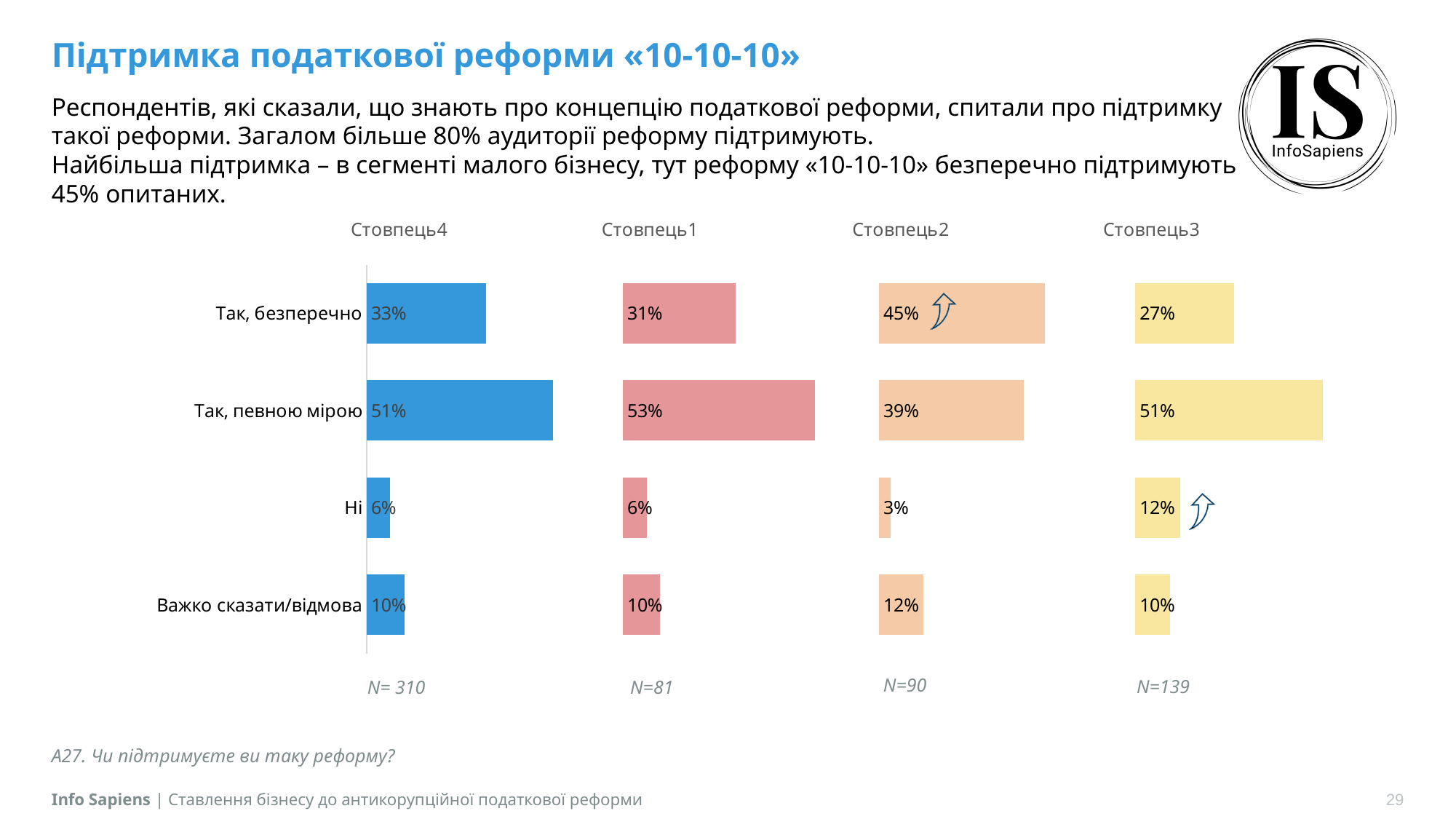
In the chart titled Стовпець4, which category has the highest value? Так, певною мірою In the chart titled Стовпець2, which category has the lowest value? Ні In the chart titled Стовпець2, what is the value for Так, безперечно? 45% In the chart titled Стовпець1, what is the difference between Так, певною мірою and Ні? 47% In the chart titled Стовпець3, what is the value for Ні? 12% In the chart titled Стовпець4, what is the value for Важко сказати/відмова? 10% In the chart titled Стовпець3, what is the difference between Так, певною мірою and Так, безперечно? 24% In the chart titled Стовпець1, what is the value for Так, певною мірою? 53% In the chart titled Стовпець2, which is larger: Так, безперечно or Так, певною мірою? Так, безперечно What sample size (N) is shown under the chart titled Стовпець3? N=139 How many categories are shown in the chart titled Стовпець1? 4 What kind of chart is the chart titled Стовпець4? bar chart